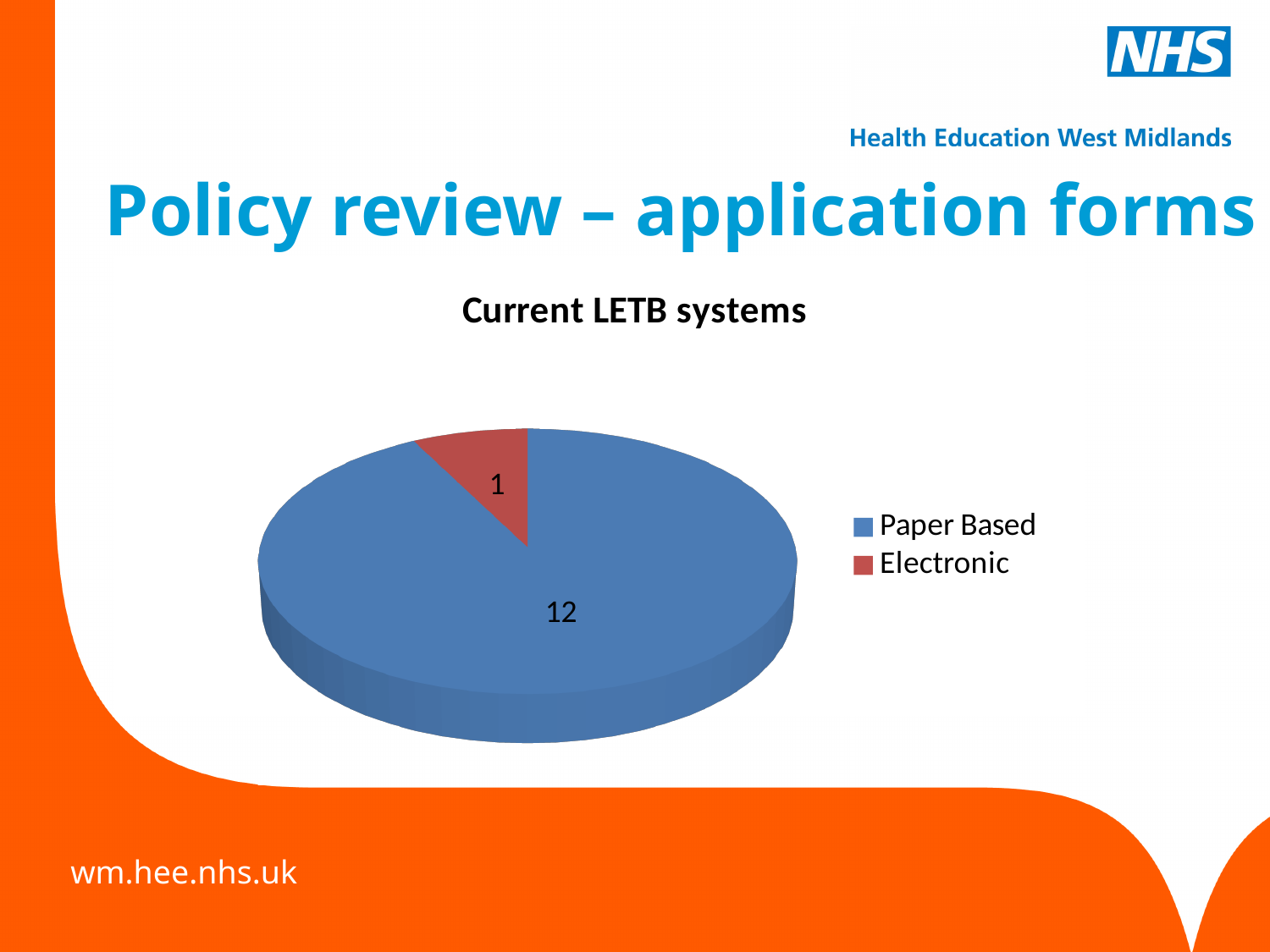
Which category has the largest slice in the Current LETB systems pie chart? Paper Based What kind of chart is shown on the slide? Pie chart What is the title of the chart on the slide? Current LETB systems What is the value for Electronic in the Current LETB systems pie chart? 1 What is the total of all slices in the Current LETB systems pie chart? 13 What colour is the Electronic slice in the Current LETB systems pie chart? Red How many categories are shown in the Current LETB systems pie chart? 2 What is the value for Paper Based in the Current LETB systems pie chart? 12 Which category has the smallest slice in the Current LETB systems pie chart? Electronic What is the difference between the Paper Based and Electronic values in the Current LETB systems chart? 11 Which is larger in the Current LETB systems chart, Paper Based or Electronic? Paper Based